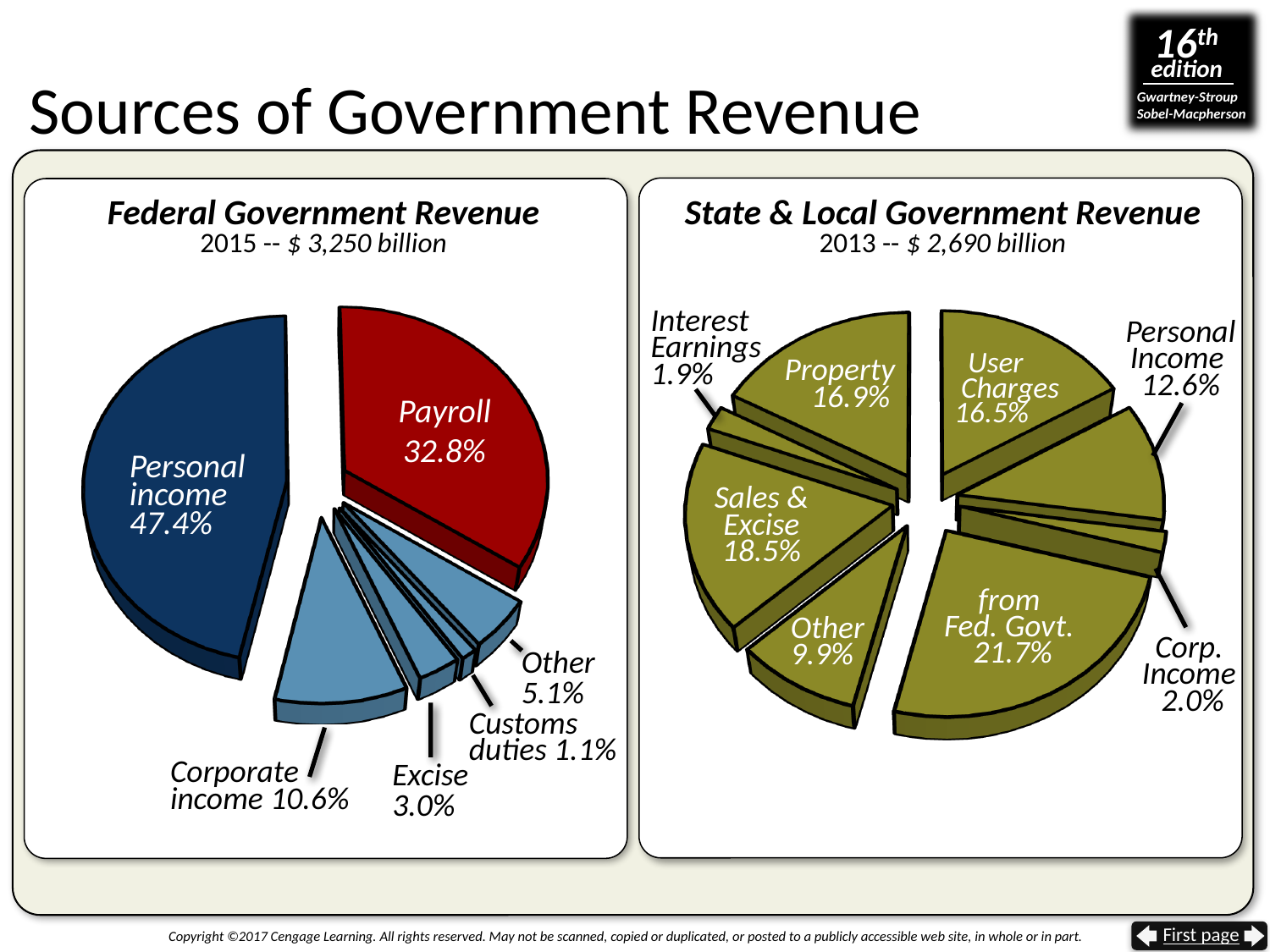
In the State & Local Government Revenue chart, which source is the largest? from Fed. Govt. In the State & Local Government Revenue chart, what share comes from Sales & Excise? 18.5% In the Federal Government Revenue chart, which source is the smallest? Customs duties In the Federal Government Revenue chart, how many slices does the pie have? 6 In the State & Local Government Revenue chart, which is larger, Property or User Charges? Property What kind of chart is the Federal Government Revenue chart? Pie chart In the Federal Government Revenue chart, what is the difference in percentage points between Personal income and Payroll? 14.6 What total revenue amount is shown in the subtitle of the Federal Government Revenue chart? $ 3,250 billion In the State & Local Government Revenue chart, how many slices does the pie have? 8 In the State & Local Government Revenue chart, which source is the smallest? Interest Earnings In the Federal Government Revenue chart, which source is the largest? Personal income In the Federal Government Revenue chart, what share of revenue comes from Payroll? 32.8%